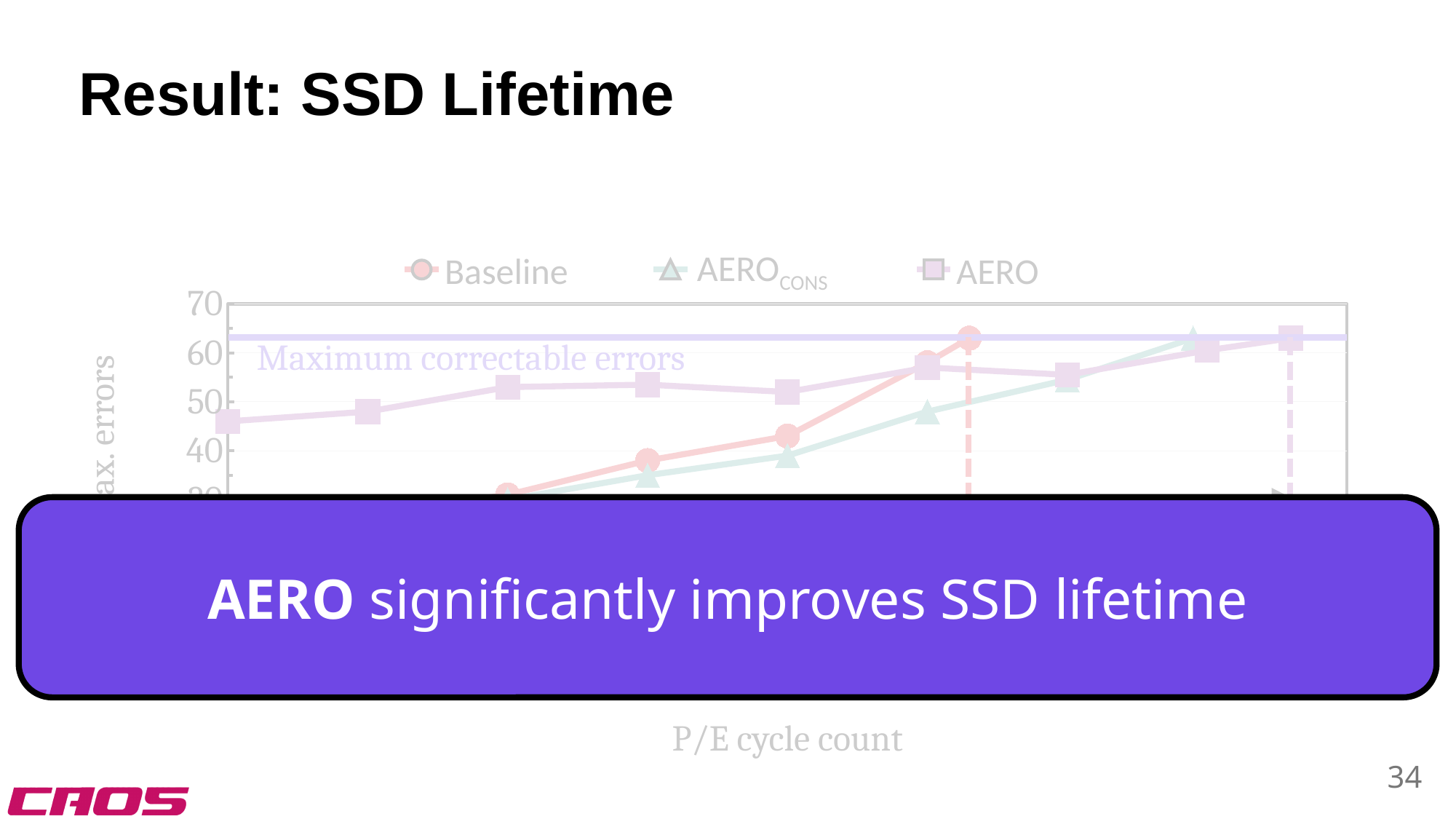
How many series does the chart legend list? 3 Does the AERO_CONS series rise or fall as the P/E cycle count increases? rise Which series reaches the maximum correctable errors line at the smallest P/E cycle count? Baseline Which series reaches the maximum correctable errors line at the largest P/E cycle count? AERO Is the value of the rightmost plotted AERO point greater or less than 60? greater What does the horizontal line near the top of the chart represent, according to its label? Maximum correctable errors What kind of chart is shown on the slide? line chart Is the value of the highest Baseline point (where its dashed vertical line is drawn) greater or less than 60? greater Is the value of the leftmost plotted AERO point greater or less than 50? less Does the Baseline series rise or fall as the P/E cycle count increases? rise What is the highest tick value shown on the y axis of the chart? 70 What is the label of the x axis of the chart? P/E cycle count